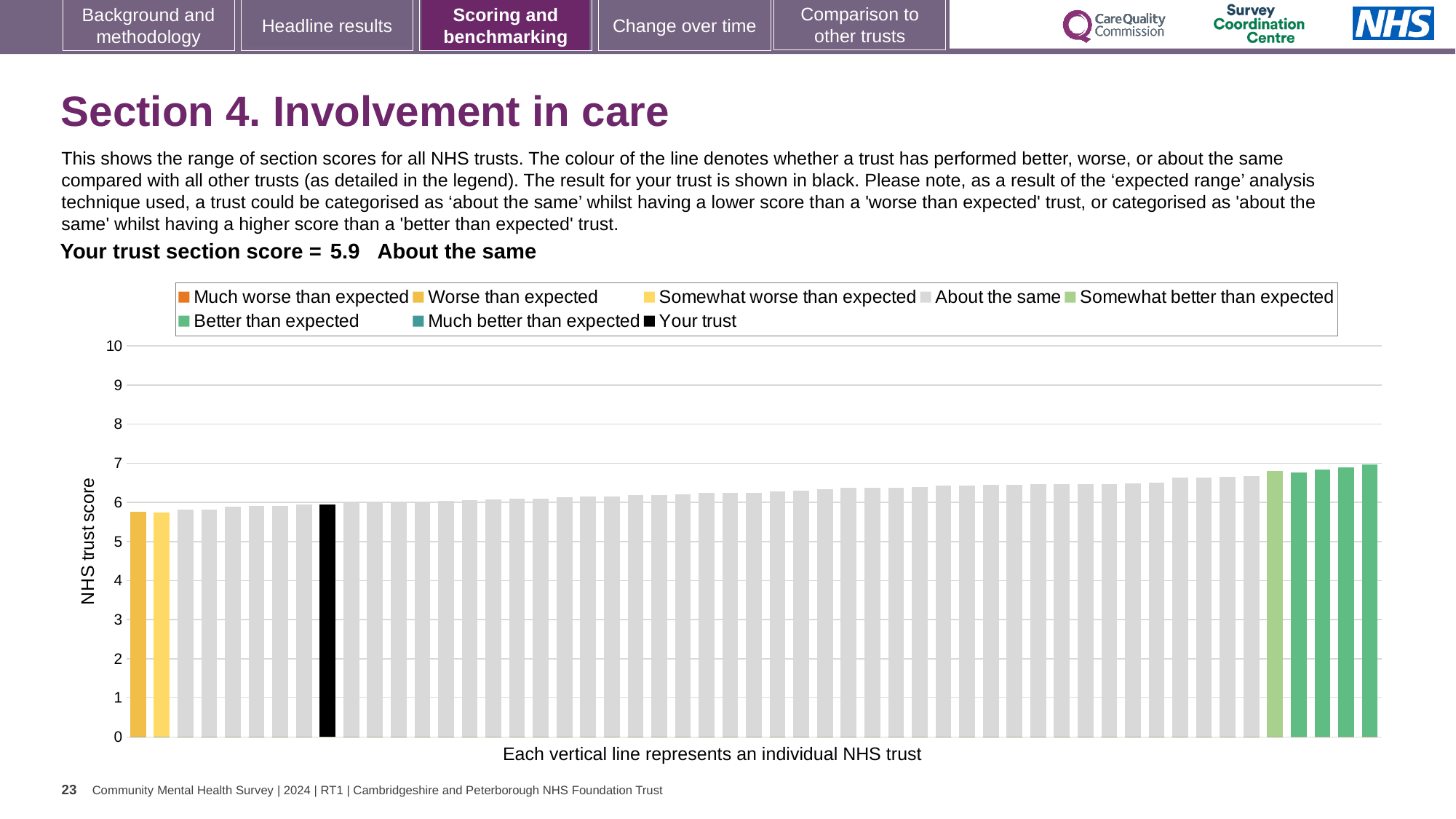
What kind of chart is shown on the slide? bar chart What is the section score for your trust shown on the slide? 5.9 How many dark green 'Better than expected' bars are shown at the right of the chart? 4 Is the value of the tallest bar greater or less than 6? greater How many entries does the chart legend list? 8 Is the value of the leftmost (shortest) bar greater or less than 6? less Is the value of the black 'Your trust' bar greater or less than 5? greater Which category is your trust's section score placed in? About the same What colour is the bar representing your trust? black What is the label on the vertical axis of the chart? NHS trust score Do the bar values rise or fall from left to right along the x axis? rise